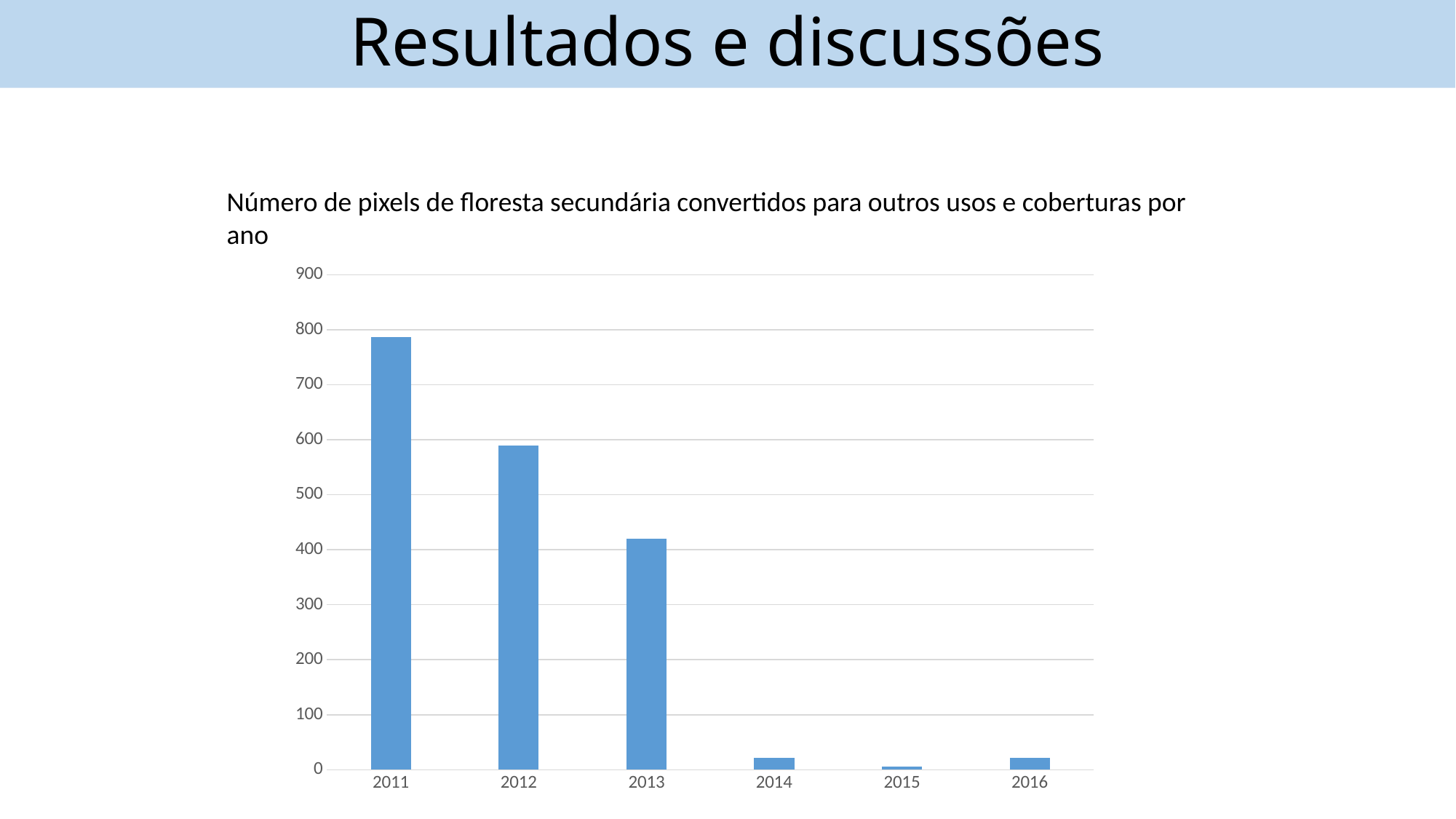
Do the values rise or fall from 2011 to 2013? fall How many years are shown on the x axis of the chart? 6 Is the value for 2013 greater or less than 500? less Is the value for 2014 greater or less than 100? less Which year has a larger value, 2011 or 2013? 2011 Which year has the lowest number of converted pixels? 2015 What kind of chart is shown on the slide? bar chart What is the title of the chart? Número de pixels de floresta secundária convertidos para outros usos e coberturas por ano Which year has the highest number of converted pixels? 2011 Is the value for 2011 greater or less than 700? greater Which year has a larger value, 2012 or 2013? 2012